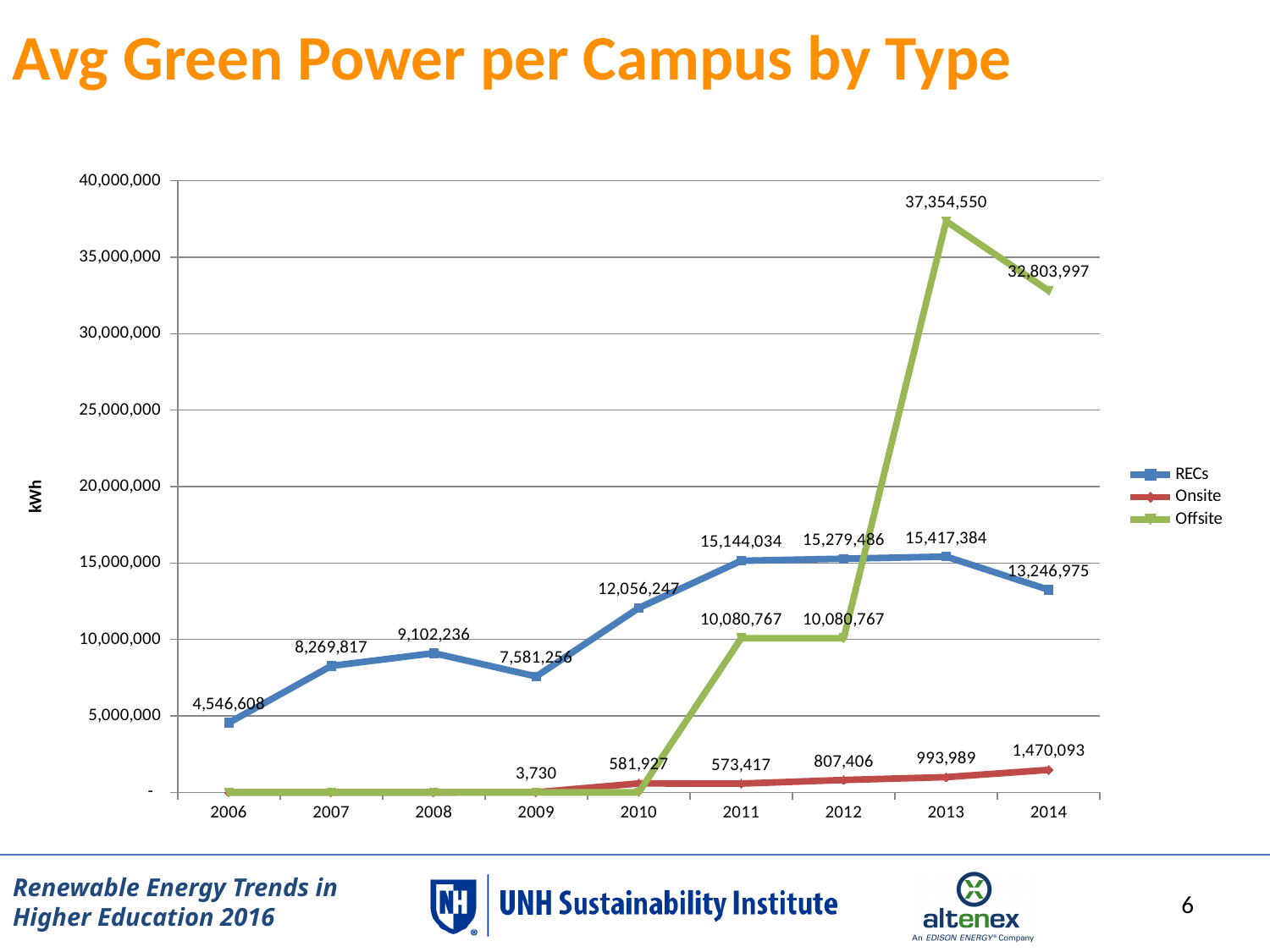
What is the difference between the Offsite values for 2013 and 2014? 4,550,553 How many years are plotted along the x axis? 9 What is the Offsite value for 2013? 37,354,550 How many series does the legend list? 3 What type of chart is shown on the slide? Line chart Does the Onsite series rise or fall from 2012 to 2014? Rise What is the Onsite value for 2014? 1,470,093 In which year is the Onsite value highest? 2014 In which year is the RECs value lowest? 2006 What is the label on the y axis? kWh In 2012, which is larger: the RECs value or the Offsite value? RECs What is the RECs value for 2010? 12,056,247